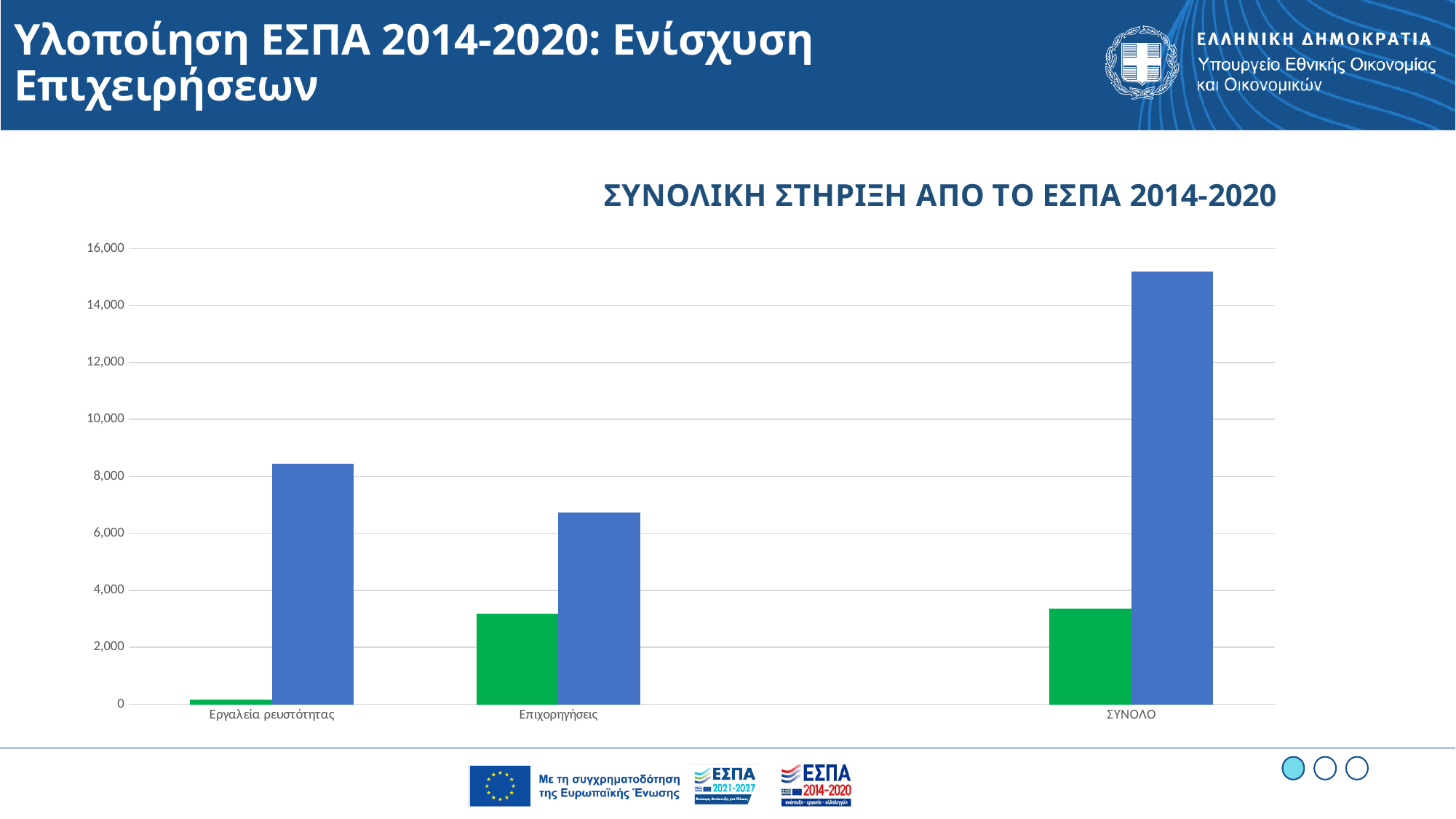
Which category has the tallest blue bar? ΣΥΝΟΛΟ Which is larger, the blue bar for Εργαλεία ρευστότητας or the blue bar for Επιχορηγήσεις? Εργαλεία ρευστότητας Is the blue bar for Εργαλεία ρευστότητας greater or less than 8,000? greater Is the blue bar for ΣΥΝΟΛΟ greater or less than 14,000? greater Which category has the shortest green bar? Εργαλεία ρευστότητας Is the green bar for Επιχορηγήσεις greater or less than 4,000? less How many categories are shown on the x axis of the chart? 3 What is the title of the chart? ΣΥΝΟΛΙΚΗ ΣΤΗΡΙΞΗ ΑΠΟ ΤΟ ΕΣΠΑ 2014-2020 What kind of chart is shown on the slide? bar chart Which is larger for Επιχορηγήσεις, the green bar or the blue bar? the blue bar